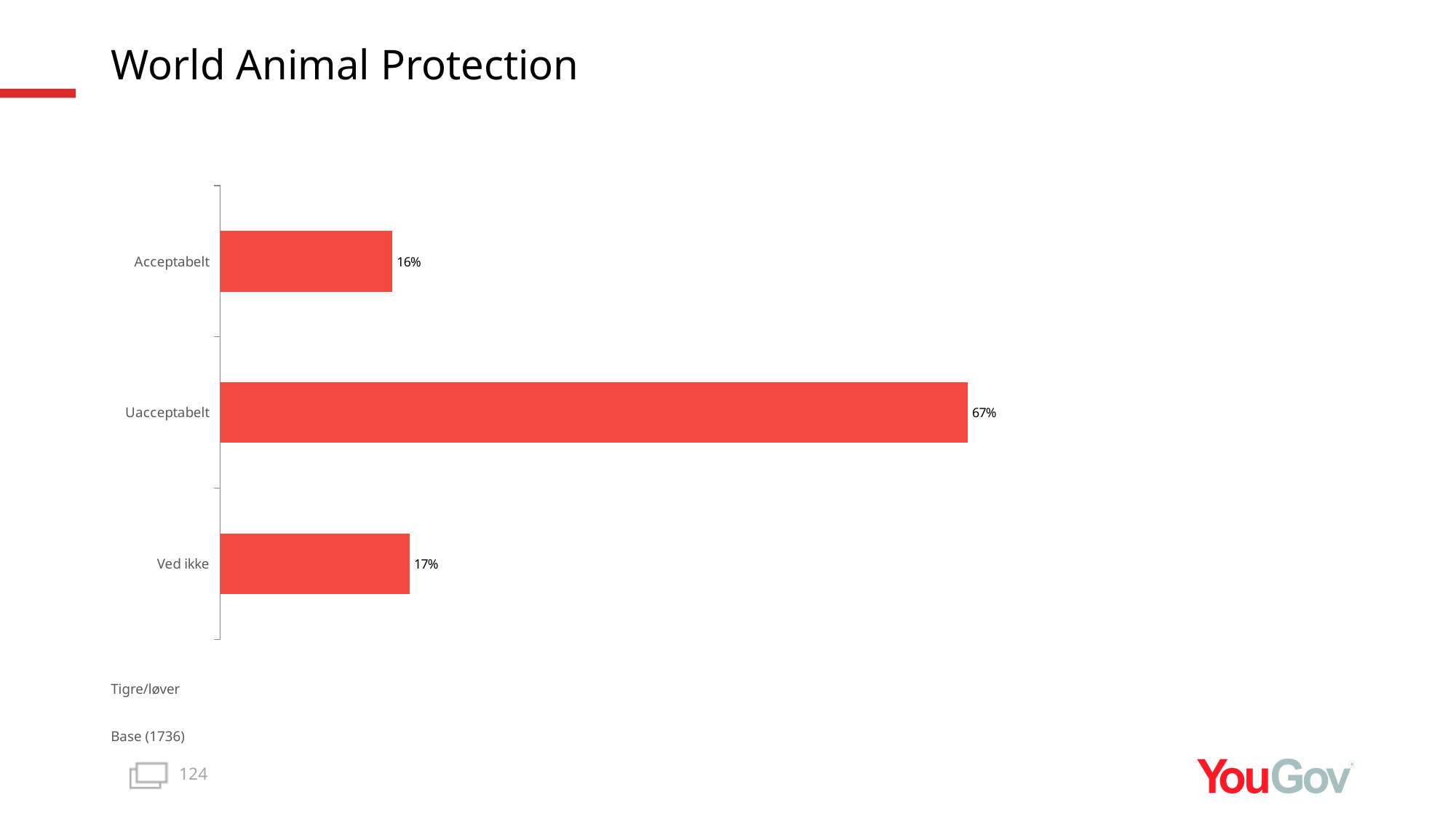
Which is larger, the value for Uacceptabelt or the value for Ved ikke? Uacceptabelt What is the base (number of respondents) noted below the chart? 1736 What kind of chart is shown on the slide? Bar chart What is the difference between the values for Ved ikke and Acceptabelt? 1 percentage point Which category has the highest value? Uacceptabelt What is the difference between the values for Uacceptabelt and Acceptabelt? 51 percentage points What label appears below the chart describing the subject of the question? Tigre/løver What is the value for Uacceptabelt? 67% How many categories are shown in the chart? 3 Which category has the lowest value? Acceptabelt What is the value for Acceptabelt? 16% What is the value for Ved ikke? 17%